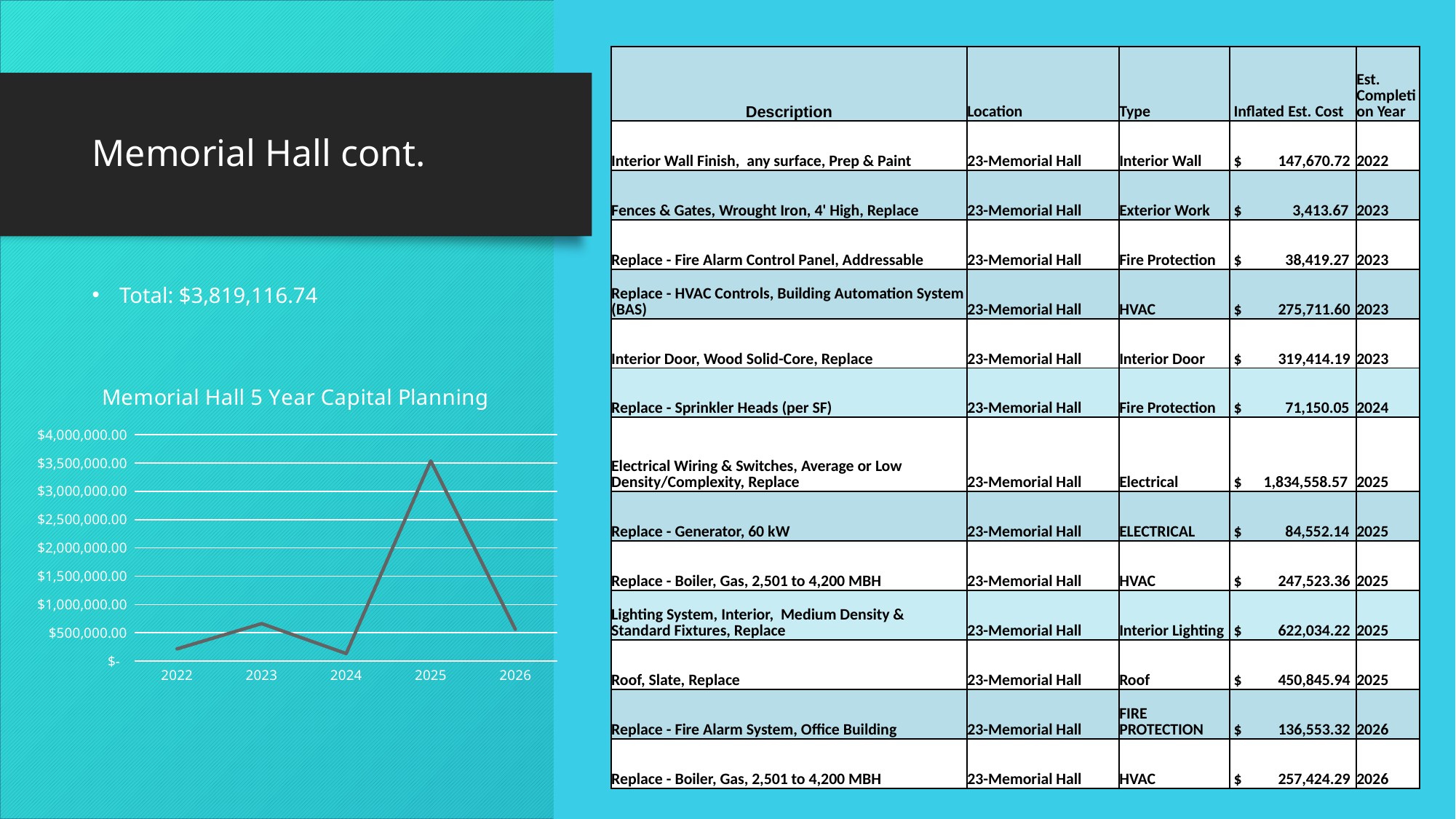
How many years are plotted along the x axis of the chart? 5 Which is larger, the value for 2025 or the value for 2023? 2025 What is the title of the chart on the slide? Memorial Hall 5 Year Capital Planning Does the line rise or fall from 2024 to 2025? rise Is the value for 2024 greater or less than $500,000.00? less What kind of chart is shown on the slide? line chart Is the value for 2025 greater or less than $3,000,000.00? greater Which year has the highest value in the chart? 2025 Does the line rise or fall from 2025 to 2026? fall What is the highest value shown on the chart's y axis? $4,000,000.00 Is the value for 2022 greater or less than $500,000.00? less